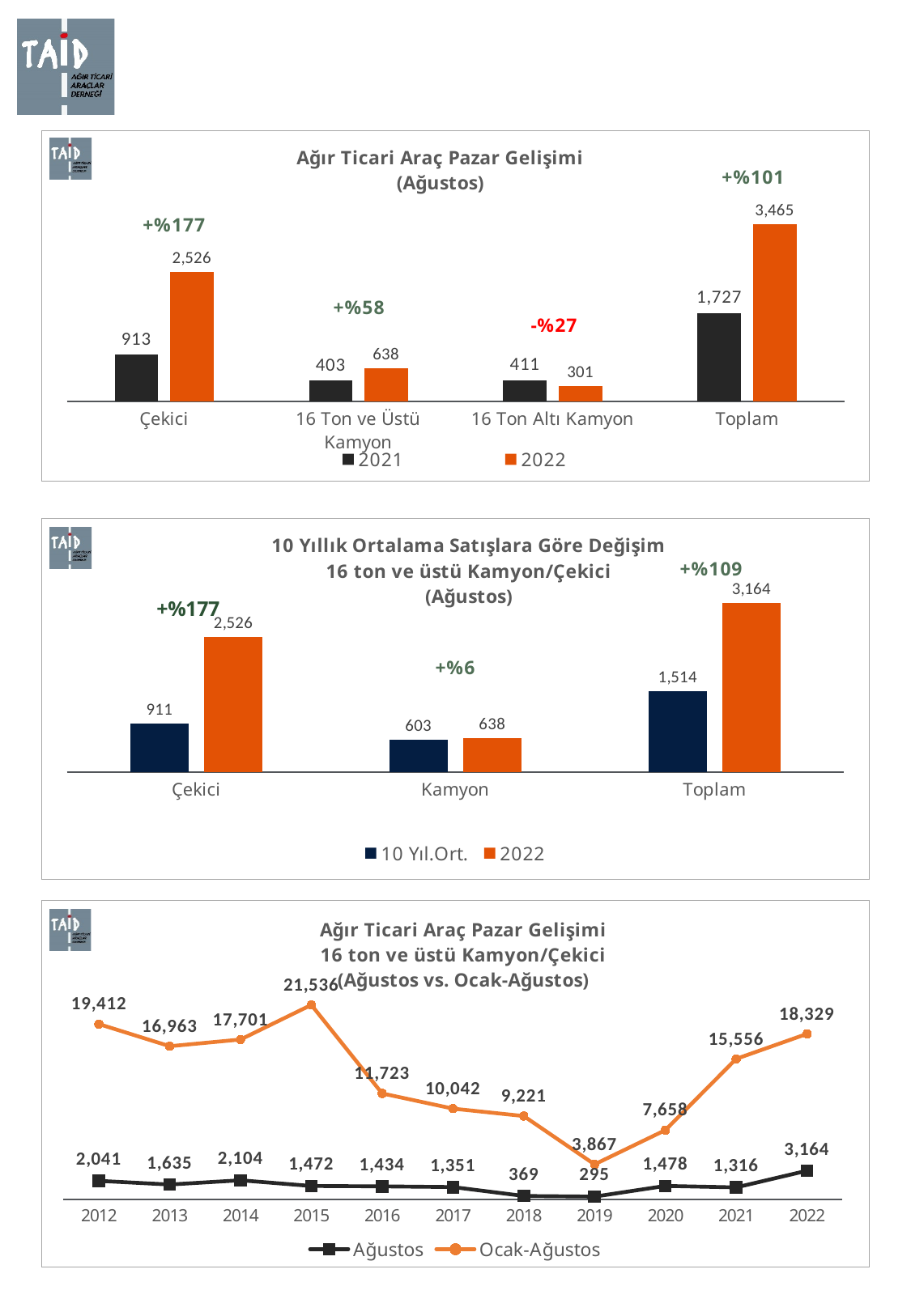
In the top chart 'Ağır Ticari Araç Pazar Gelişimi (Ağustos)', what is the 2022 value for Çekici? 2,526 In the bottom chart, which year has the lowest Ağustos value? 2019 In the middle chart '10 Yıllık Ortalama Satışlara Göre Değişim', how many categories are shown on the x axis? 3 In the middle chart '10 Yıllık Ortalama Satışlara Göre Değişim', what is the 2022 value for Toplam? 3,164 In the top chart 'Ağır Ticari Araç Pazar Gelişimi (Ağustos)', what is the difference between the 2022 and 2021 values for Toplam? 1,738 In the top chart 'Ağır Ticari Araç Pazar Gelişimi (Ağustos)', which category has the lowest 2022 value? 16 Ton Altı Kamyon What kind of chart is the bottom chart 'Ağır Ticari Araç Pazar Gelişimi 16 ton ve üstü Kamyon/Çekici'? Line chart In the top chart 'Ağır Ticari Araç Pazar Gelişimi (Ağustos)', what is the 2021 value for 16 Ton Altı Kamyon? 411 In the bottom chart, what is the Ocak-Ağustos value for 2015? 21,536 In the top chart 'Ağır Ticari Araç Pazar Gelişimi (Ağustos)', how many series does the legend list? 2 In the bottom chart, which is larger: the Ocak-Ağustos value for 2021 or for 2022? 2022 In the middle chart '10 Yıllık Ortalama Satışlara Göre Değişim', what is the 10 Yıl.Ort. value for Kamyon? 603